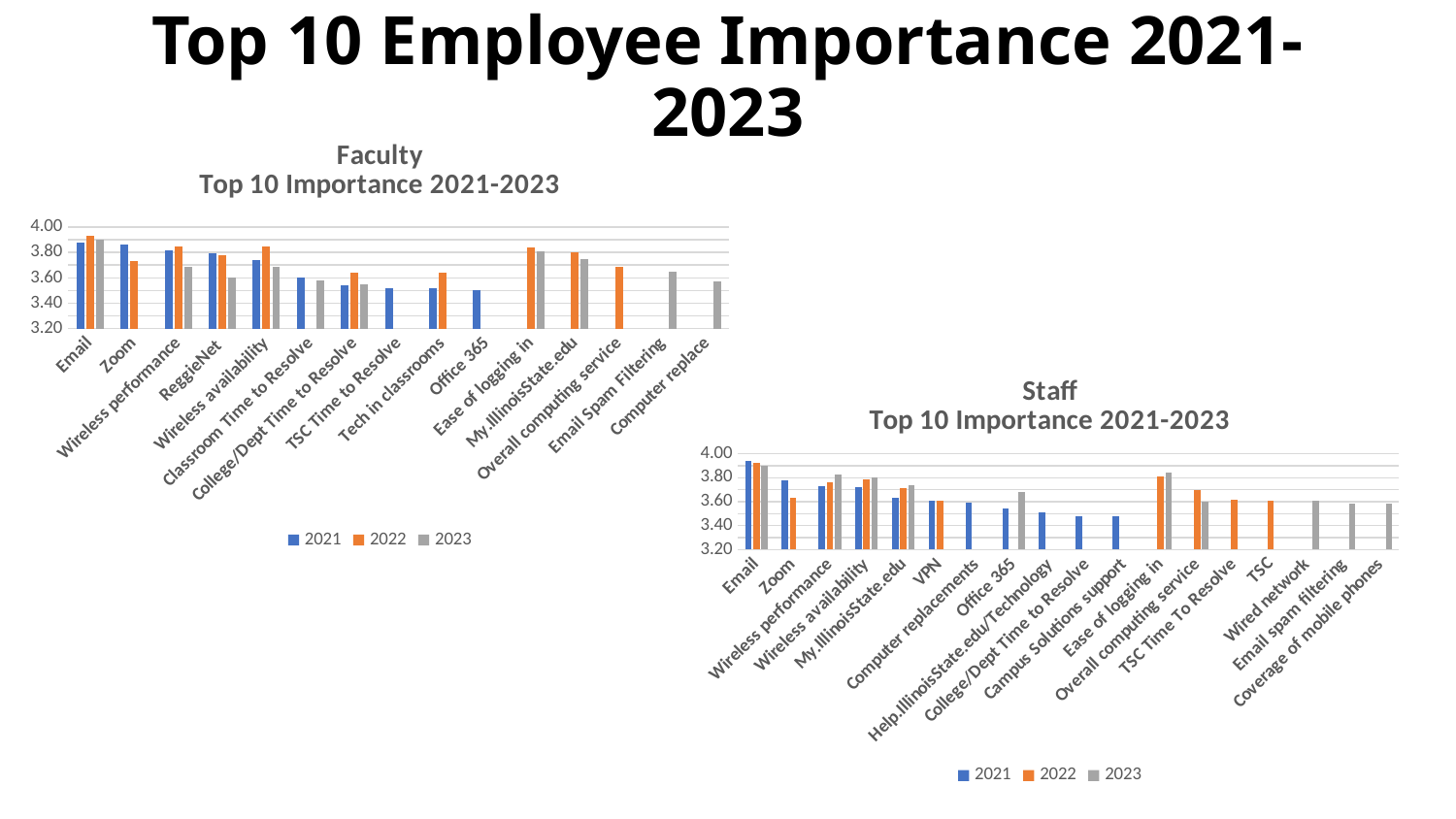
In the Staff Top 10 Importance 2021-2023 chart, is the 2021 value for Campus Solutions support greater or less than 3.60? less In the Staff Top 10 Importance 2021-2023 chart, is the 2021 value for Email greater or less than 3.80? greater How many series does the legend of the Staff Top 10 Importance 2021-2023 chart list? 3 In the Faculty Top 10 Importance 2021-2023 chart, is the 2022 value for Email greater or less than 3.80? greater In the Faculty Top 10 Importance 2021-2023 chart, which category has the highest 2022 value? Email In the Staff Top 10 Importance 2021-2023 chart, which category has the highest 2021 value? Email In the Staff Top 10 Importance 2021-2023 chart, which has the larger 2022 value, Email or Zoom? Email What kind of chart is the Faculty Top 10 Importance 2021-2023 chart? bar chart How many categories are shown on the x axis of the Staff Top 10 Importance 2021-2023 chart? 18 What are the legend entries on the Faculty Top 10 Importance 2021-2023 chart? 2021, 2022, 2023 How many categories are shown on the x axis of the Faculty Top 10 Importance 2021-2023 chart? 15